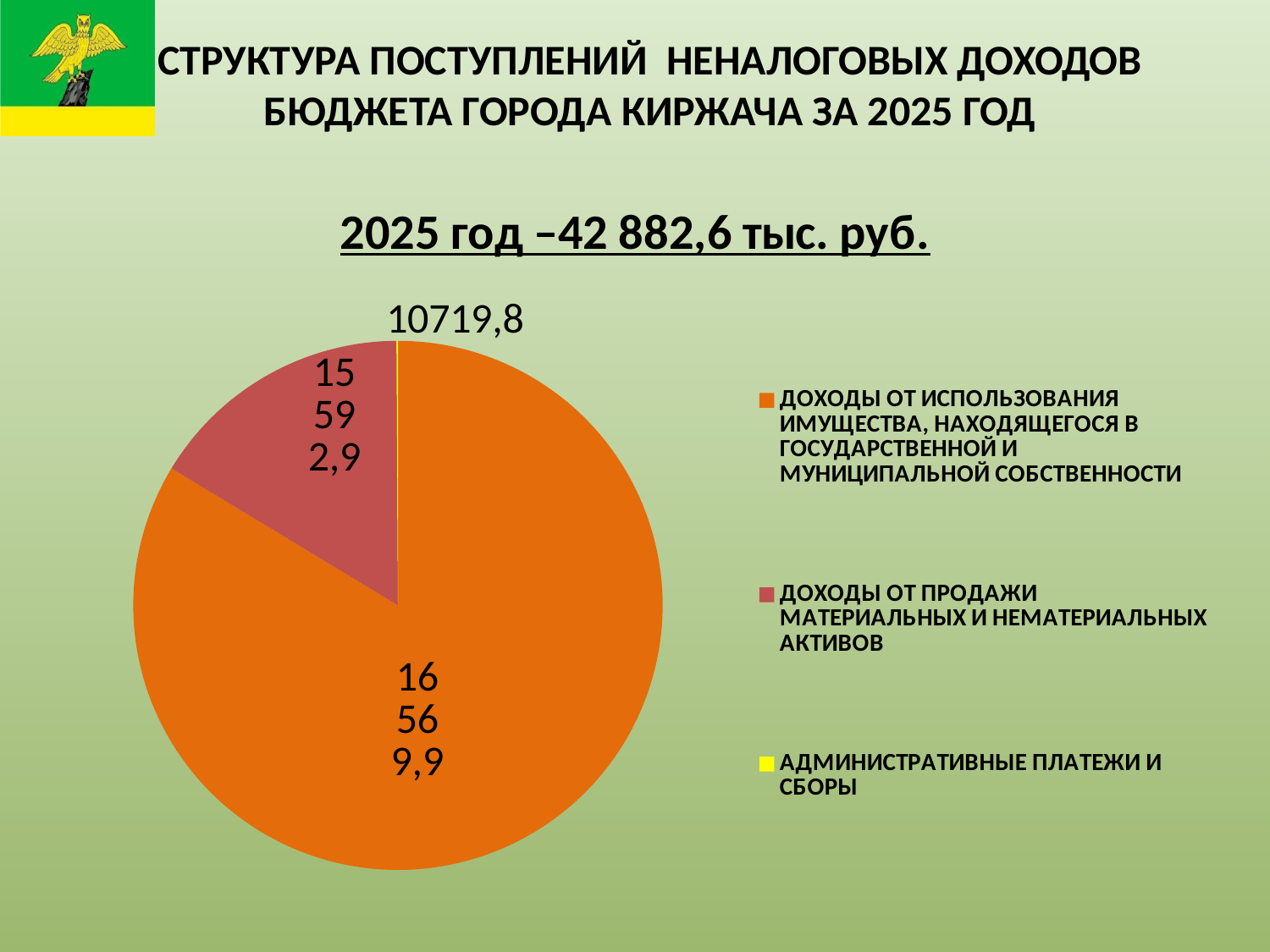
Which category has the smallest slice of the pie? АДМИНИСТРАТИВНЫЕ ПЛАТЕЖИ И СБОРЫ Which is larger: the slice for ДОХОДЫ ОТ ИСПОЛЬЗОВАНИЯ ИМУЩЕСТВА or the slice for ДОХОДЫ ОТ ПРОДАЖИ МАТЕРИАЛЬНЫХ И НЕМАТЕРИАЛЬНЫХ АКТИВОВ? ДОХОДЫ ОТ ИСПОЛЬЗОВАНИЯ ИМУЩЕСТВА Which category has the largest slice of the pie? ДОХОДЫ ОТ ИСПОЛЬЗОВАНИЯ ИМУЩЕСТВА, НАХОДЯЩЕГОСЯ В ГОСУДАРСТВЕННОЙ И МУНИЦИПАЛЬНОЙ СОБСТВЕННОСТИ What year does the slide title say the structure of non-tax revenues refers to? 2025 How many entries does the legend of the pie chart list? 3 What kind of chart is shown on the slide? pie chart What total amount for 2025 is stated above the pie chart? 42 882,6 тыс. руб. What colour is the slice for ДОХОДЫ ОТ ПРОДАЖИ МАТЕРИАЛЬНЫХ И НЕМАТЕРИАЛЬНЫХ АКТИВОВ? red How many slices does the pie chart have? 3 What value is labelled on the orange slice (ДОХОДЫ ОТ ИСПОЛЬЗОВАНИЯ ИМУЩЕСТВА...)? 16569,9 What value is labelled for АДМИНИСТРАТИВНЫЕ ПЛАТЕЖИ И СБОРЫ? 10719,8 What value is labelled on the red slice (ДОХОДЫ ОТ ПРОДАЖИ МАТЕРИАЛЬНЫХ И НЕМАТЕРИАЛЬНЫХ АКТИВОВ)? 15592,9